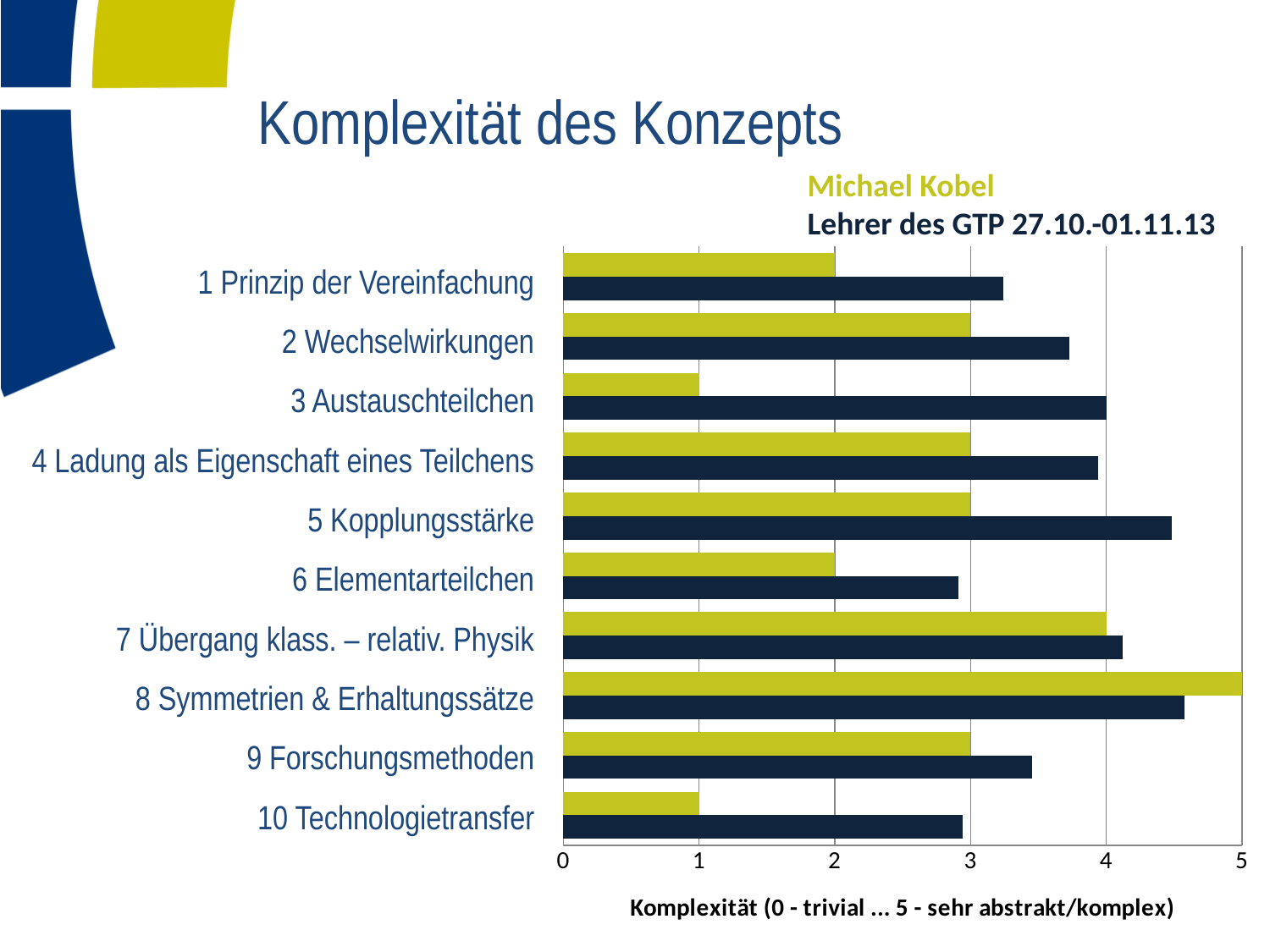
What is the label of the horizontal axis? Komplexität (0 - trivial ... 5 - sehr abstrakt/komplex) For '3 Austauschteilchen', which series has the larger value: Michael Kobel or Lehrer des GTP 27.10.-01.11.13? Lehrer des GTP 27.10.-01.11.13 What kind of chart is shown on the slide? bar chart What is the value for Michael Kobel for '10 Technologietransfer'? 1 Which category has the highest value for Michael Kobel? 8 Symmetrien & Erhaltungssätze Is the value for 'Lehrer des GTP 27.10.-01.11.13' for '6 Elementarteilchen' greater or less than 3? less Is the value for 'Lehrer des GTP 27.10.-01.11.13' for '5 Kopplungsstärke' greater or less than 4? greater What is the value for Michael Kobel for '8 Symmetrien & Erhaltungssätze'? 5 What is the value for Michael Kobel for '7 Übergang klass. – relativ. Physik'? 4 How many categories (concepts) are plotted on the chart? 10 What is the value for Michael Kobel for '3 Austauschteilchen'? 1